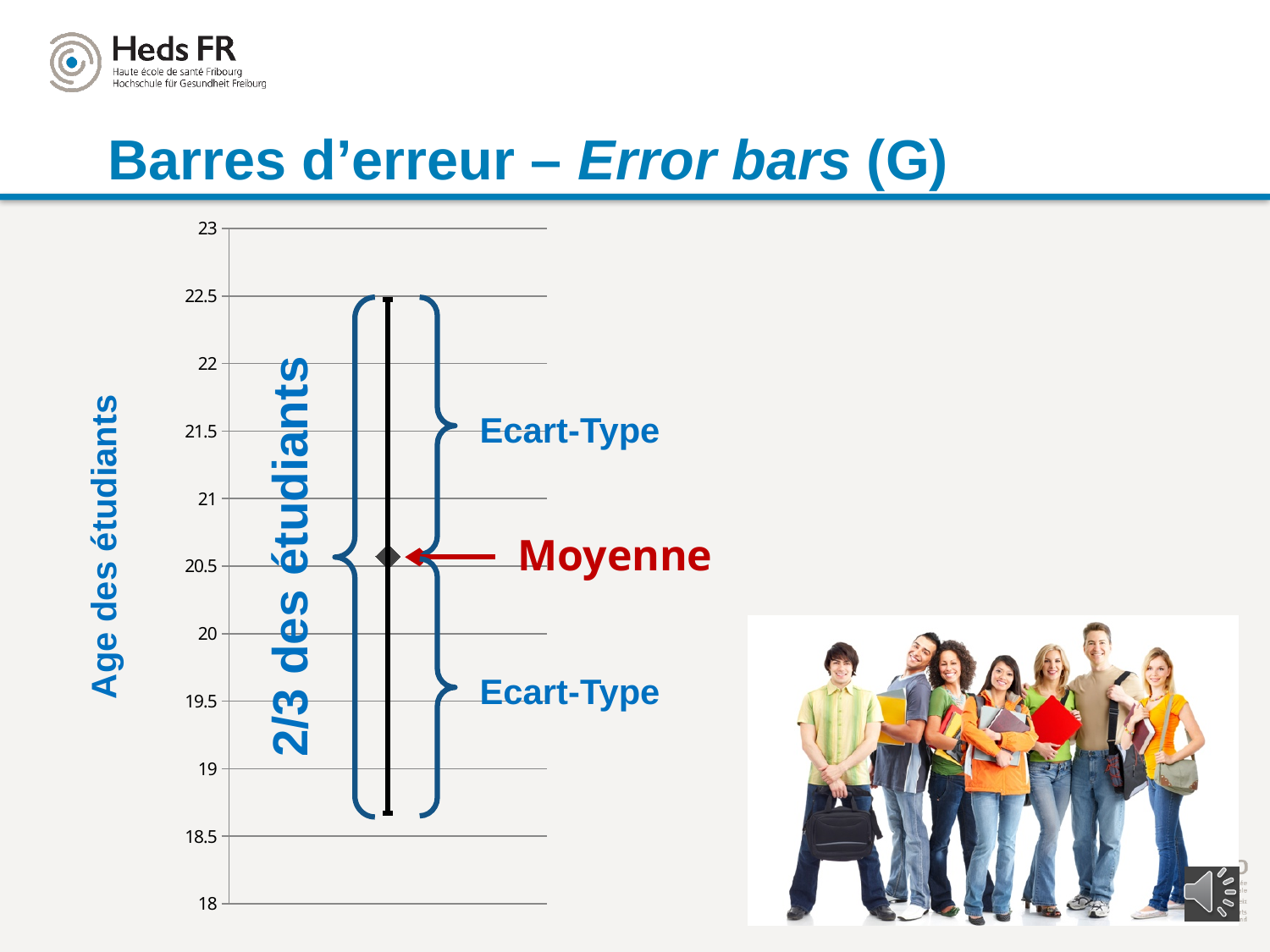
Is the top end of the error bar in the chart greater or less than 22? greater What does the red arrow in the chart point to, according to its label? Moyenne What is the label on the vertical axis of the chart? Age des étudiants What is the highest value shown on the vertical axis of the chart? 23 How many data points (means) are plotted in the chart? 1 What kind of chart is shown on the slide? Error bar chart (a mean point with error bars) Is the mean (Moyenne) value shown in the chart greater or less than 21? less Is the mean (Moyenne) value shown in the chart greater or less than 20? greater